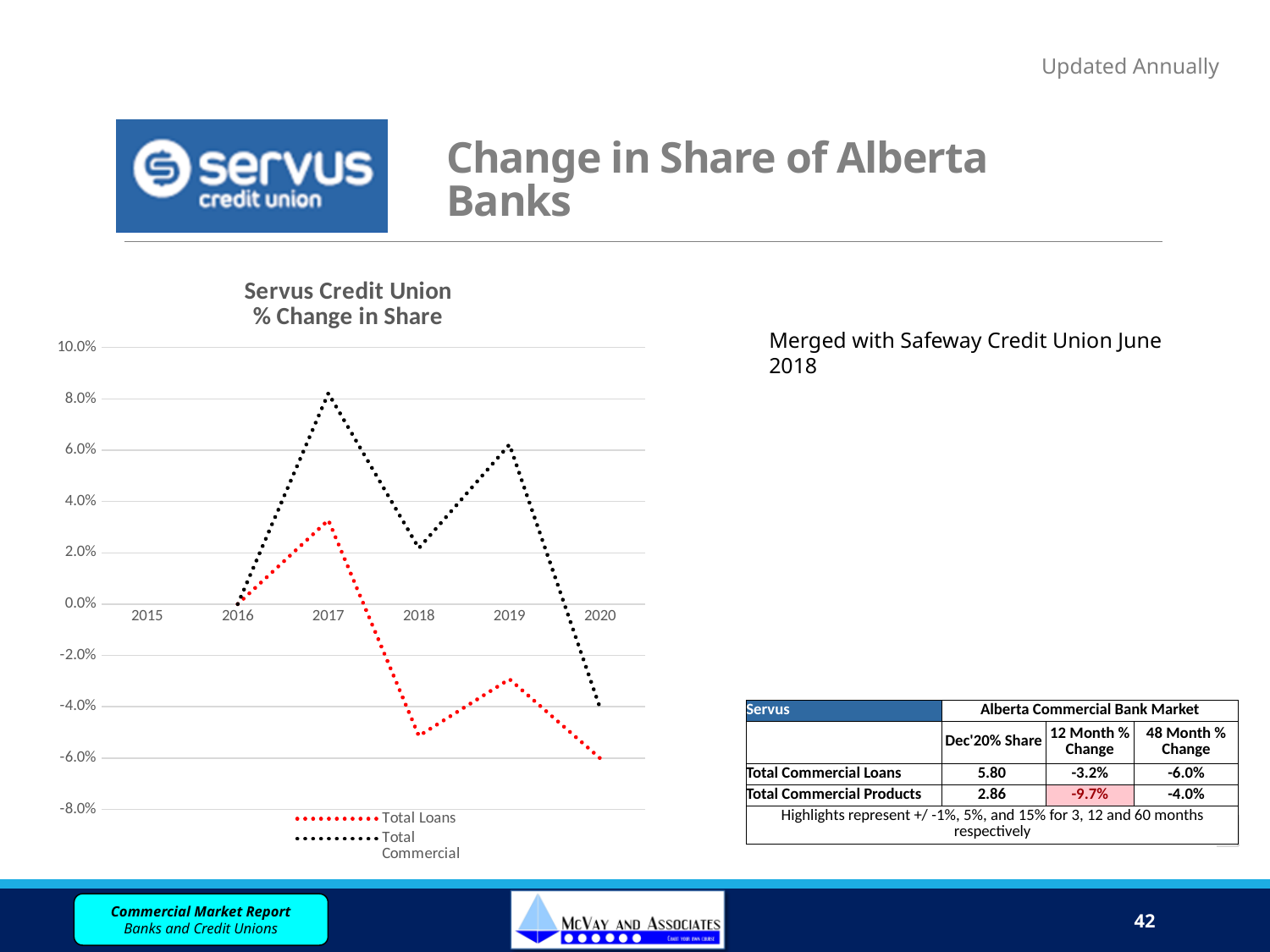
What kind of chart is shown on the slide? line chart In which year does the Total Commercial series reach its highest value? 2017 Does the Total Commercial series rise or fall from 2019 to 2020? fall Is the value for Total Loans in 2018 greater or less than -4.0%? less Is the value for Total Commercial in 2017 greater or less than 6.0%? greater In 2019, which series has the larger value, Total Loans or Total Commercial? Total Commercial How many series does the chart legend list? 2 In which year does the Total Loans series reach its lowest value? 2020 Which series is drawn in red? Total Loans Is the value for Total Commercial in 2020 greater or less than -2.0%? less In which year does the Total Loans series reach its highest value? 2017 What is the title of the chart? Servus Credit Union % Change in Share